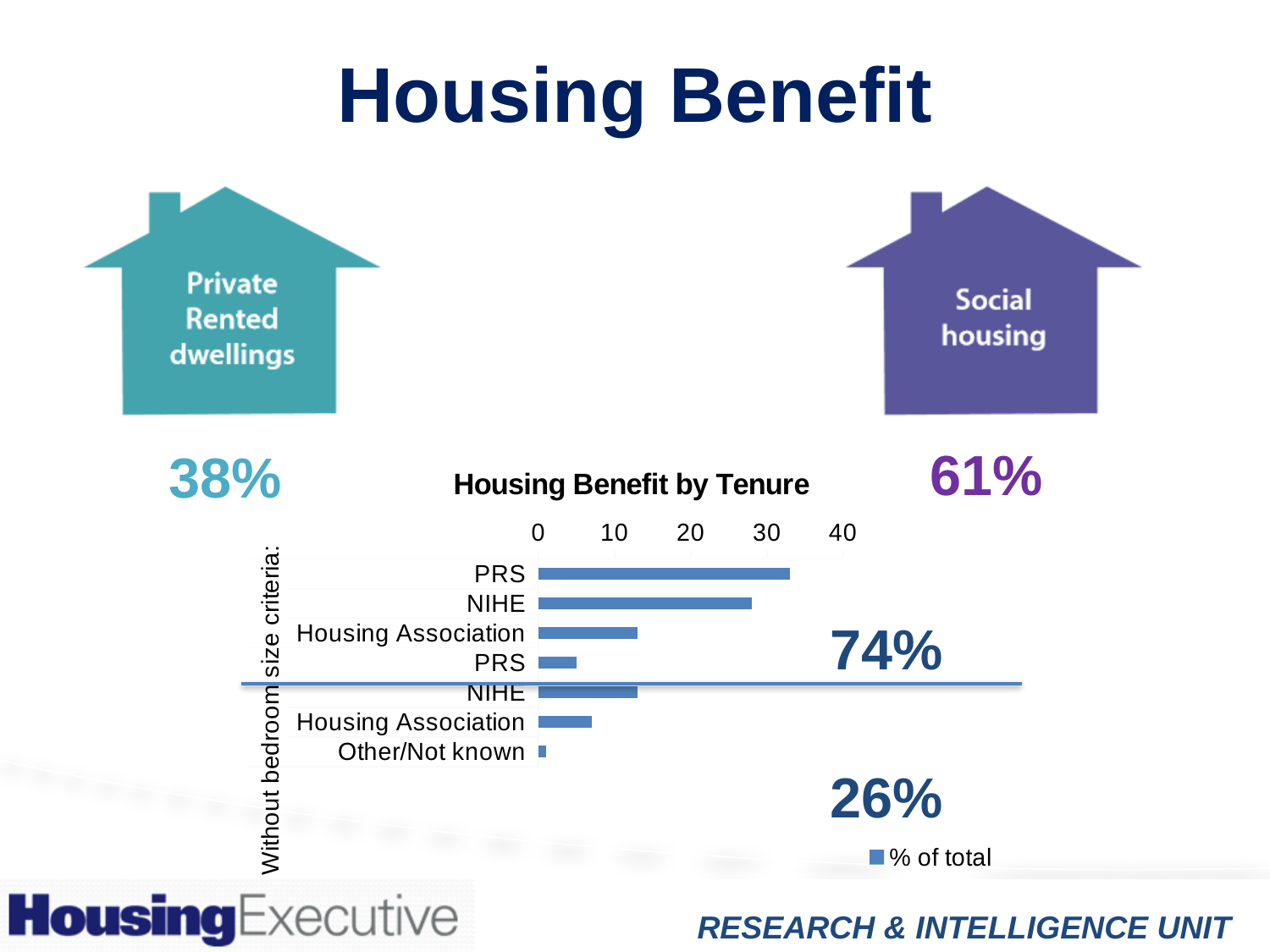
Which category has the shortest bar in the chart? Other/Not known How many bars are plotted in the chart? 7 Is the value for the top PRS bar greater or less than 30? greater Which category has the longest bar in the chart? PRS (top bar) Is the value for Other/Not known greater or less than 10? less Which is larger, the top PRS bar or the top NIHE bar? PRS Is the value for the lower PRS bar (fourth from the top) greater or less than 10? less How many series does the chart's legend list? 1 What is the title of the chart on the slide? Housing Benefit by Tenure What kind of chart is shown on the slide? bar chart What is the legend entry for the series in the chart? % of total